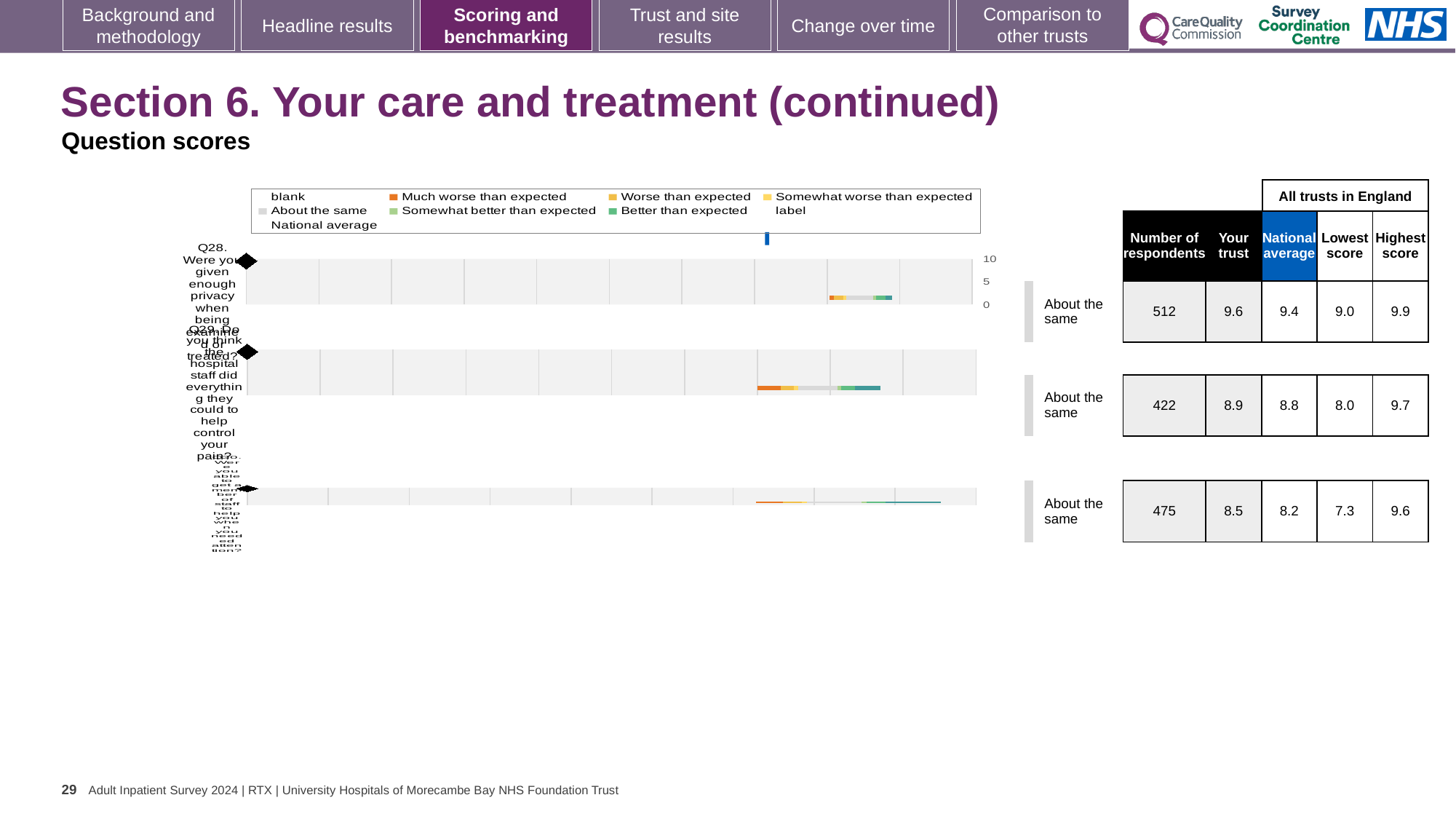
What kind of chart is used to show the question scores on this slide? Bar chart What is the national average score for Q29 (Do you think the hospital staff did everything they could to help control your pain?)? 8.8 For Q29, which is larger: the 'Your trust' score or the national average? Your trust Which question has the lowest 'Your trust' score on this slide? Q30 What is the lowest score among all trusts in England for Q30? 7.3 What benchmark category is shown for Q29? About the same What is the 'Your trust' score for Q28 (Were you given enough privacy when being examined or treated?)? 9.6 Which question has the highest 'Your trust' score on this slide? Q28 What is the highest score among all trusts in England for Q28? 9.9 How many respondents answered Q30? 475 How many questions are plotted on this slide? 3 What is the difference between the 'Your trust' score and the national average for Q30? 0.3